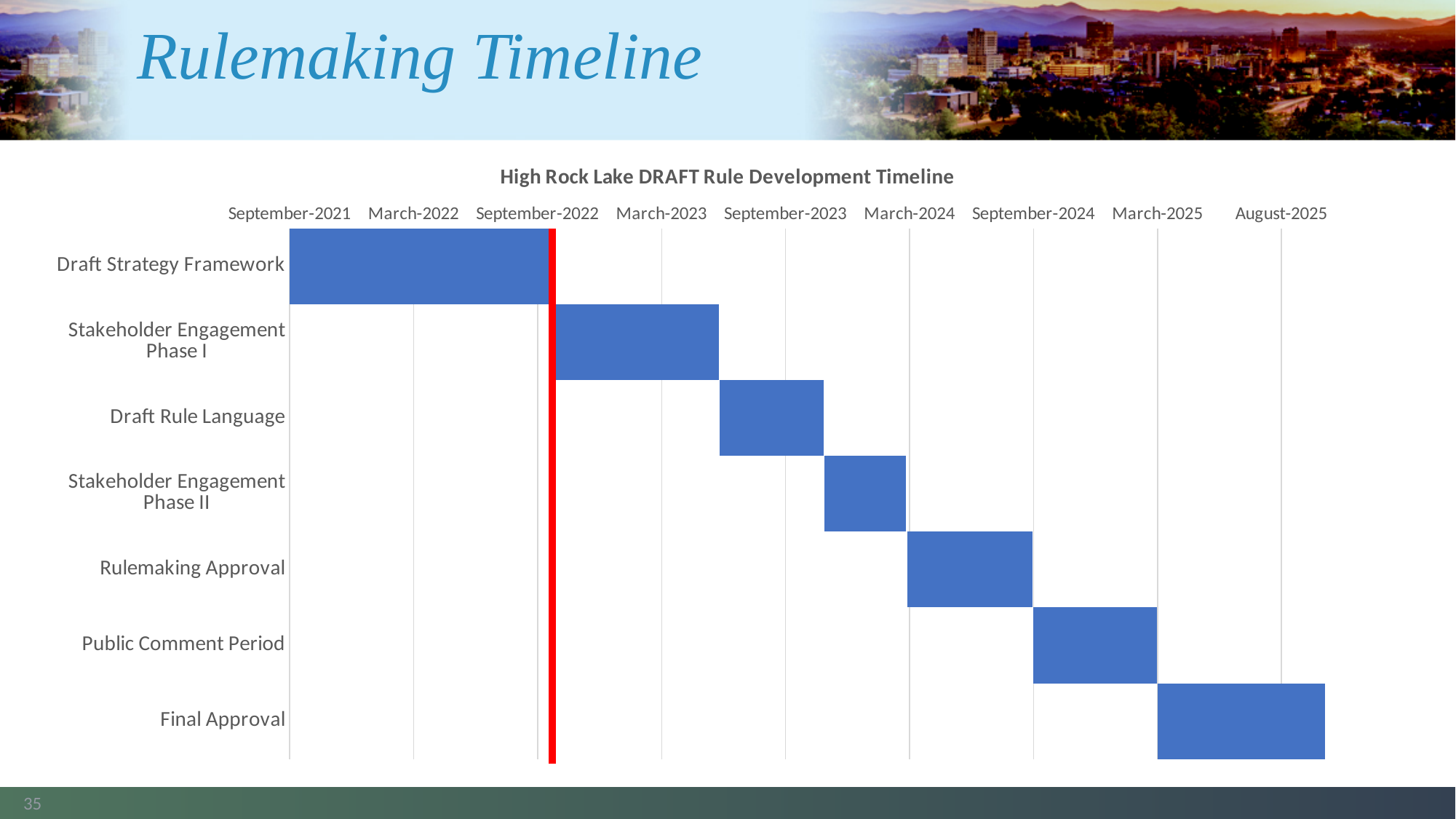
Which task's bar starts at March-2024? Rulemaking Approval What is the title of the chart? High Rock Lake DRAFT Rule Development Timeline Which bar is longer, Draft Strategy Framework or Final Approval? Draft Strategy Framework Which task's bar starts at September-2021? Draft Strategy Framework Which task's bar ends at August-2025? Final Approval Between which two axis labels does the red vertical line fall? September-2022 and March-2023 What kind of chart is shown on the slide? Bar chart Which task's bar starts at March-2025? Final Approval How many tasks (categories) are listed on the chart? 7 Which task's bar starts at September-2024? Public Comment Period Which task has the longest bar on the chart? Draft Strategy Framework Which bar is longer, Rulemaking Approval or Draft Rule Language? Rulemaking Approval